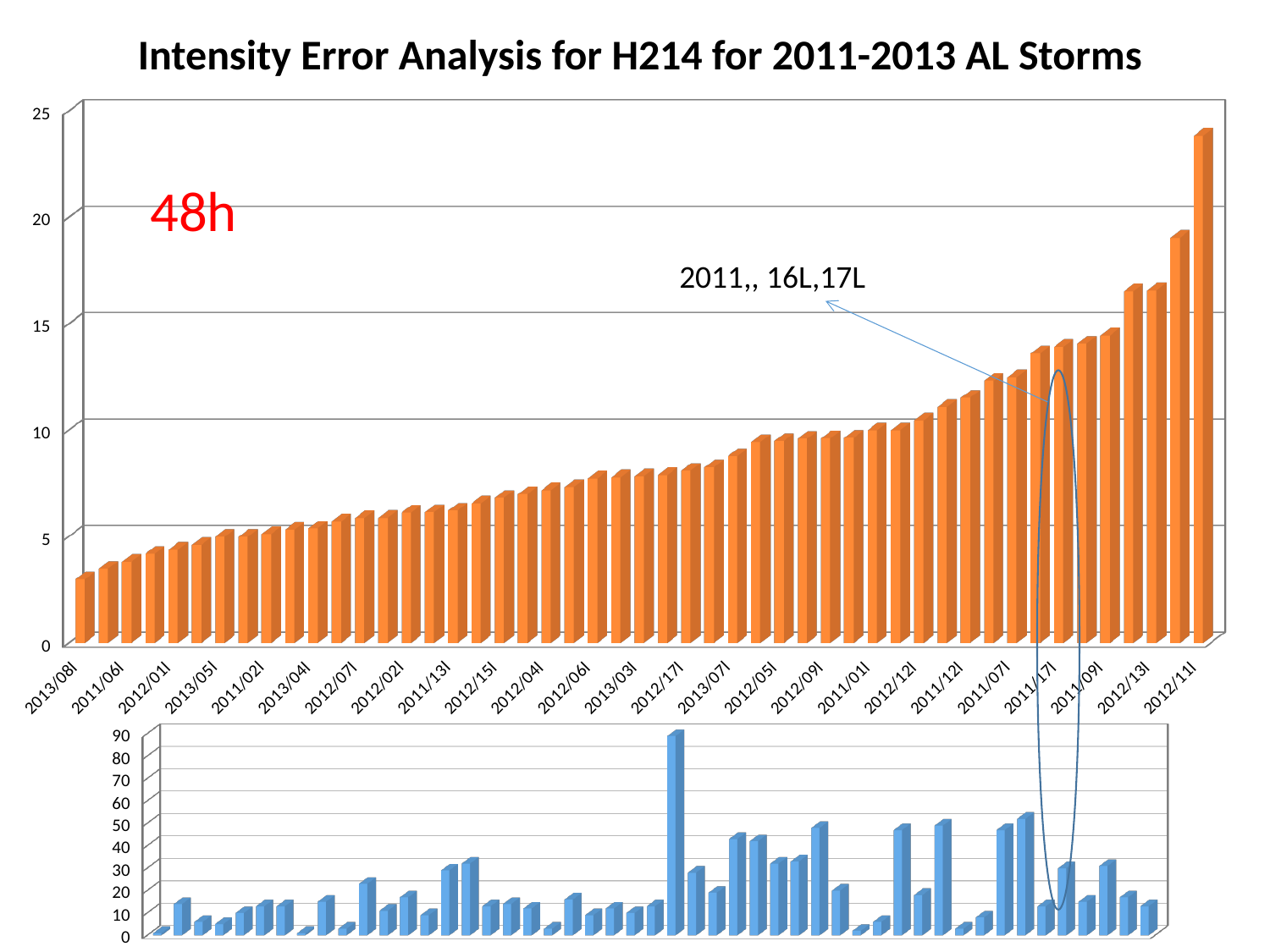
What type of chart is the top (orange) chart? bar chart In the top orange chart, which is larger: the value for 2011/09l or the value for 2011/06l? 2011/09l What forecast lead time is written in red on the top chart? 48h In the top orange chart, which category has the lowest value? 2013/08l In the bottom blue chart, is the tallest bar greater or less than 80? greater In the top orange chart, is the value for 2012/11l greater or less than 20? greater In the top orange chart, do the values rise or fall from left to right along the x axis? rise In the top orange chart, which category has the highest value? 2012/11l In the top orange chart, is the value for 2013/03l greater or less than 10? less What is the title of the slide's chart? Intensity Error Analysis for H214 for 2011-2013 AL Storms